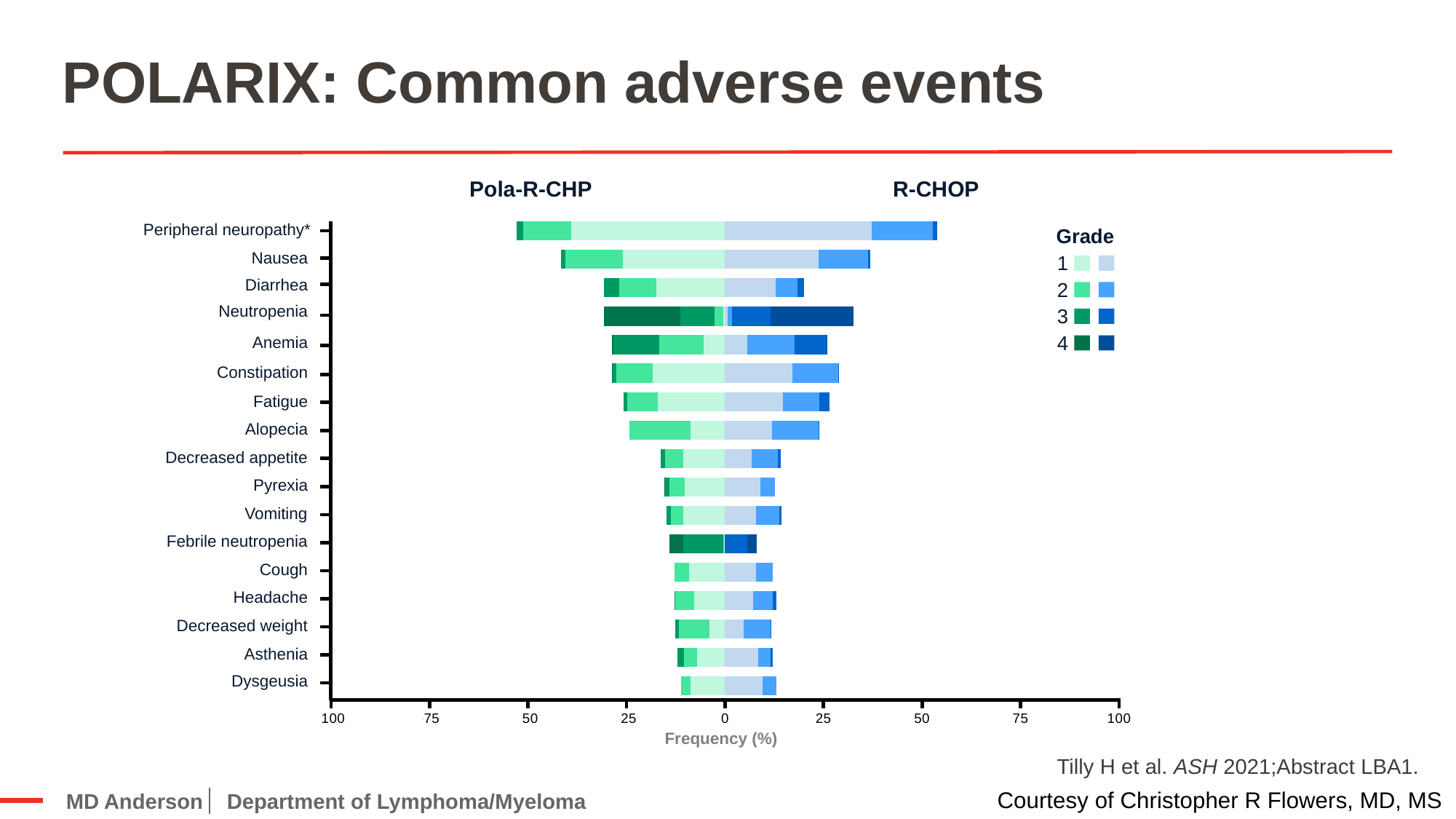
What kind of chart is shown on the slide? bar chart In the R-CHOP arm, which has the higher frequency, Peripheral neuropathy* or Nausea? Peripheral neuropathy* Is the frequency of Nausea in the R-CHOP arm greater or less than 25? greater Which adverse event has the highest frequency in the Pola-R-CHP arm? Peripheral neuropathy* How many adverse event categories are listed on the chart? 17 Is the frequency of Dysgeusia in the Pola-R-CHP arm greater or less than 25? less Is the frequency of Nausea in the Pola-R-CHP arm greater or less than 50? less Which adverse event has the highest frequency in the R-CHOP arm? Peripheral neuropathy* What is the title of the x axis? Frequency (%) In the Pola-R-CHP arm, which has the higher frequency, Nausea or Diarrhea? Nausea How many grades does the legend list? 4